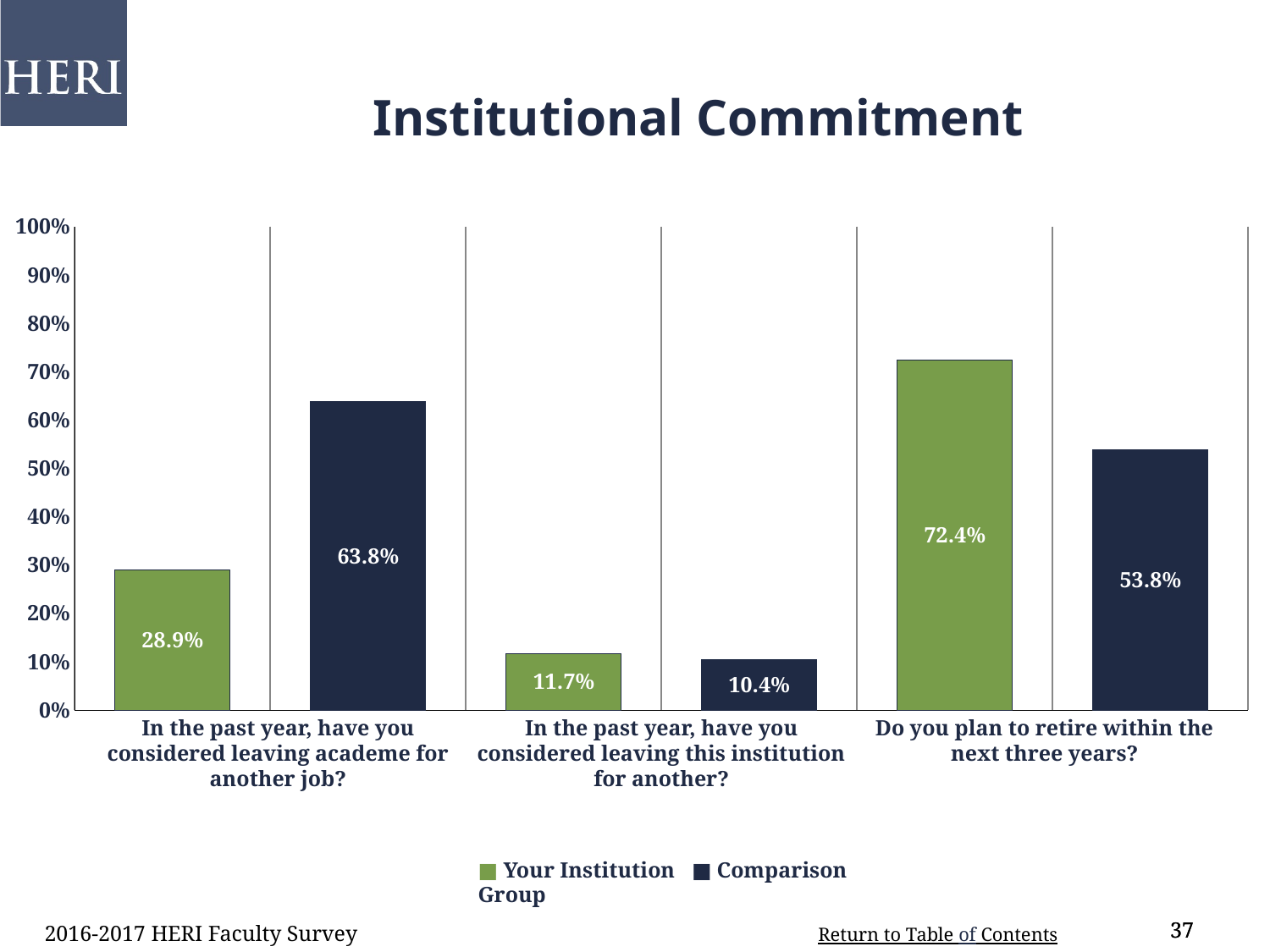
Which question has the lowest value for Comparison Group? In the past year, have you considered leaving this institution for another? How many series does the legend list? 2 What is the difference between Comparison Group and Your Institution for "In the past year, have you considered leaving academe for another job?" 34.9% What is the value for Comparison Group for "In the past year, have you considered leaving academe for another job?" 63.8% What is the value for Your Institution for "In the past year, have you considered leaving academe for another job?" 28.9% What is the difference between Your Institution and Comparison Group for "Do you plan to retire within the next three years?" 18.6% What kind of chart is shown on the slide? Bar chart How many questions (categories) are shown on the x axis? 3 Which question has the highest value for Your Institution? Do you plan to retire within the next three years? For "In the past year, have you considered leaving this institution for another?", which is larger: Your Institution or Comparison Group? Your Institution What is the value for Your Institution for "Do you plan to retire within the next three years?" 72.4% What is the value for Comparison Group for "In the past year, have you considered leaving this institution for another?" 10.4%